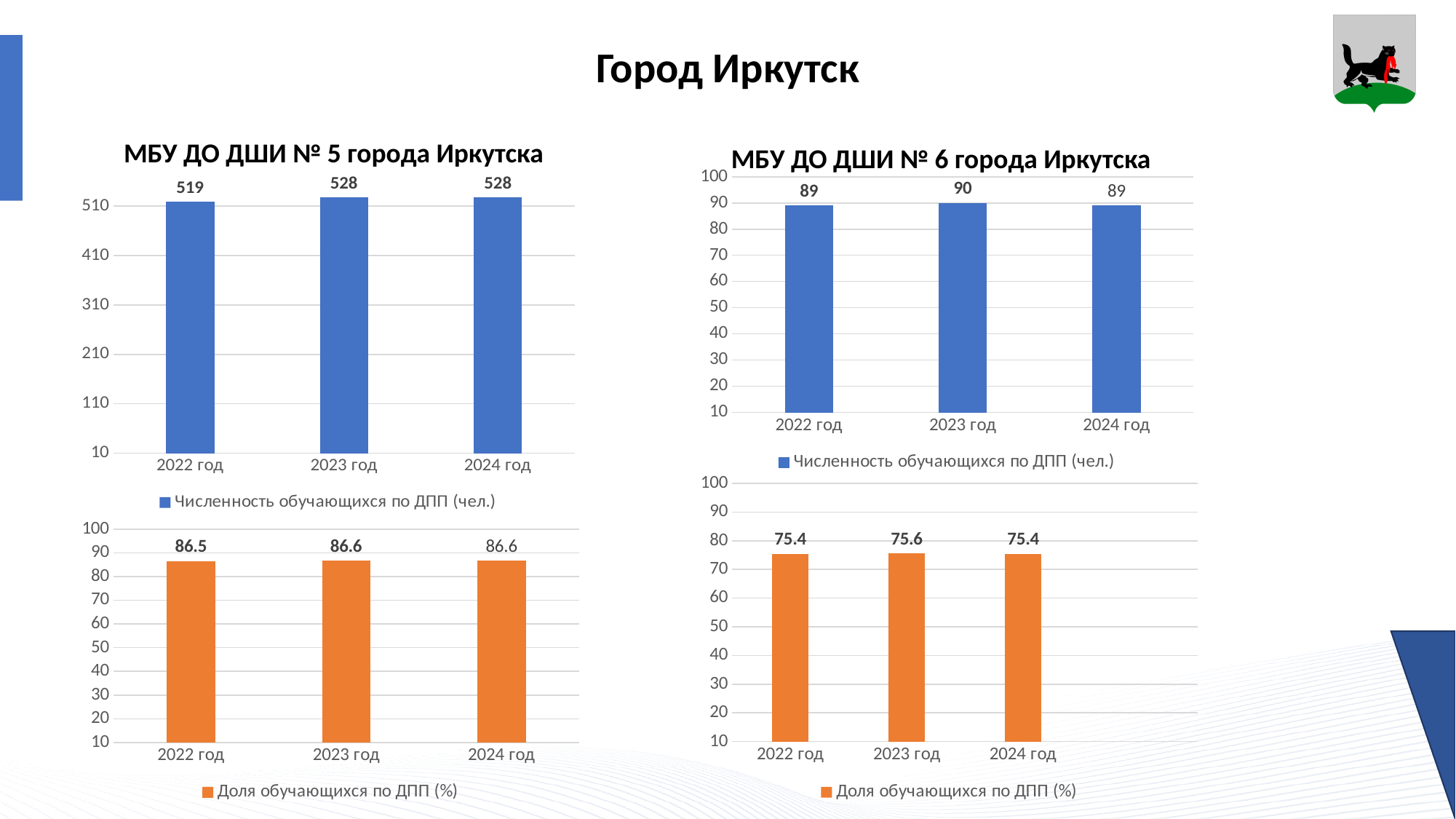
What is the legend entry of the bottom-left chart for ДШИ № 5? Доля обучающихся по ДПП (%) In the bottom-right chart for ДШИ № 6 (Доля обучающихся по ДПП (%)), what is the value for 2023 год? 75.6 What kind of chart is the top-right chart 'МБУ ДО ДШИ № 6 города Иркутска'? bar chart In the bottom-left chart for ДШИ № 5 (Доля обучающихся по ДПП (%)), what is the value for 2022 год? 86.5 In the top-right chart 'МБУ ДО ДШИ № 6 города Иркутска' (Численность обучающихся по ДПП), which year has the highest value? 2023 год In the top-left chart 'МБУ ДО ДШИ № 5 города Иркутска' (Численность обучающихся по ДПП), which year has the lowest value? 2022 год In the top-right chart 'МБУ ДО ДШИ № 6 города Иркутска' (Численность обучающихся по ДПП), what is the value for 2023 год? 90 In the bottom-left chart for ДШИ № 5 (Доля обучающихся по ДПП (%)), how many years are shown? 3 In the top-left chart 'МБУ ДО ДШИ № 5 города Иркутска' (Численность обучающихся по ДПП), what is the value for 2024 год? 528 In the bottom-right chart for ДШИ № 6 (Доля обучающихся по ДПП (%)), is the value for 2022 год greater or less than 80? less In the top-left chart 'МБУ ДО ДШИ № 5 города Иркутска' (Численность обучающихся по ДПП), what is the difference between the 2023 год and 2022 год values? 9 In the top-left chart 'МБУ ДО ДШИ № 5 города Иркутска' (Численность обучающихся по ДПП), what is the value for 2022 год? 519